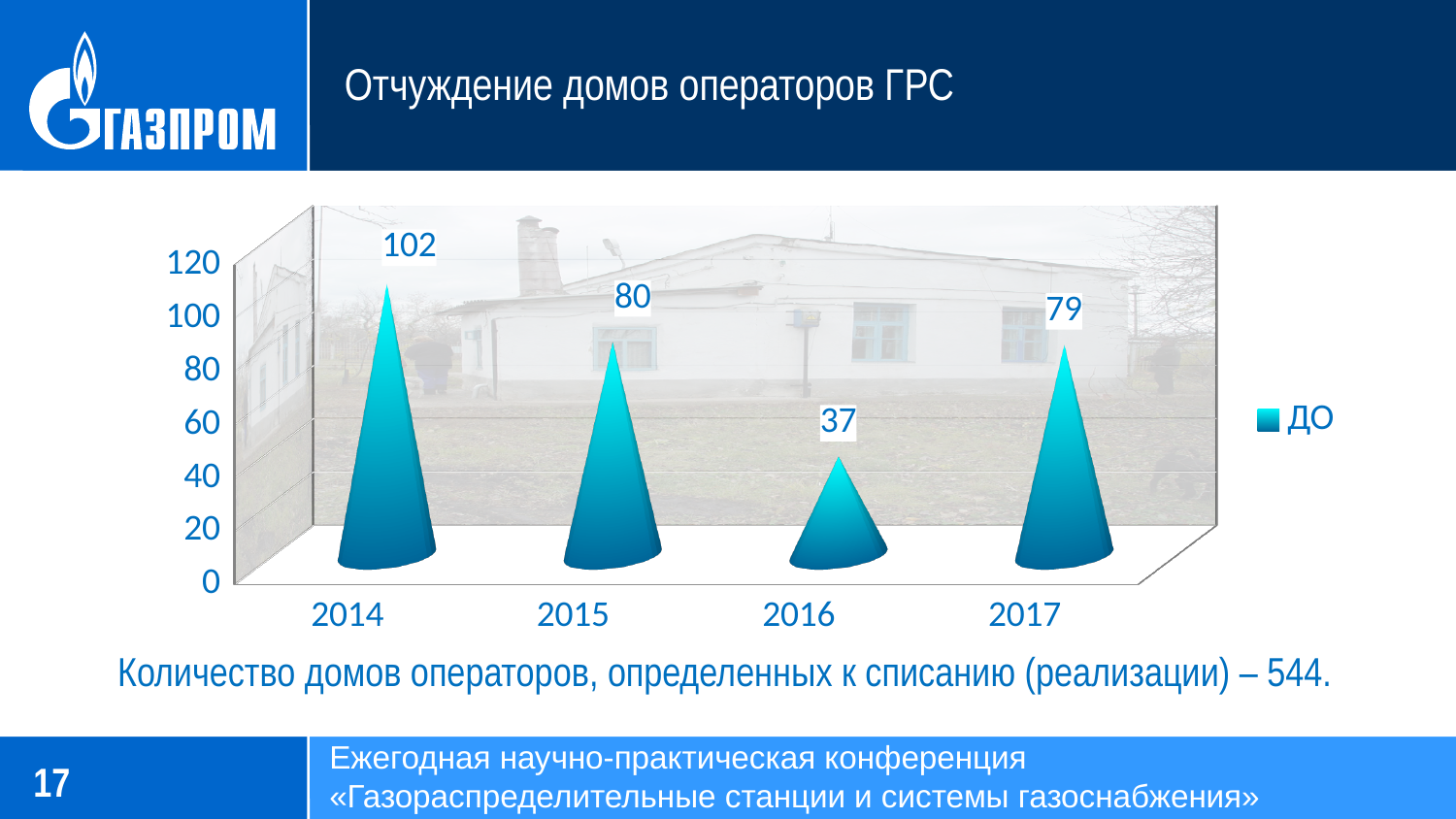
How many years are shown on the x axis? 4 How many series does the legend list? 1 Which is larger, the value for 2015 or the value for 2017? 2015 What is the difference between the values for 2015 and 2016? 43 What is the difference between the values for 2014 and 2015? 22 What is the value for 2017? 79 Which year has the lowest value? 2016 Which year has the highest value? 2014 What is the value for 2016? 37 What is the legend entry for the series? ДО What is the value for 2014? 102 What kind of chart is shown on the slide? bar chart